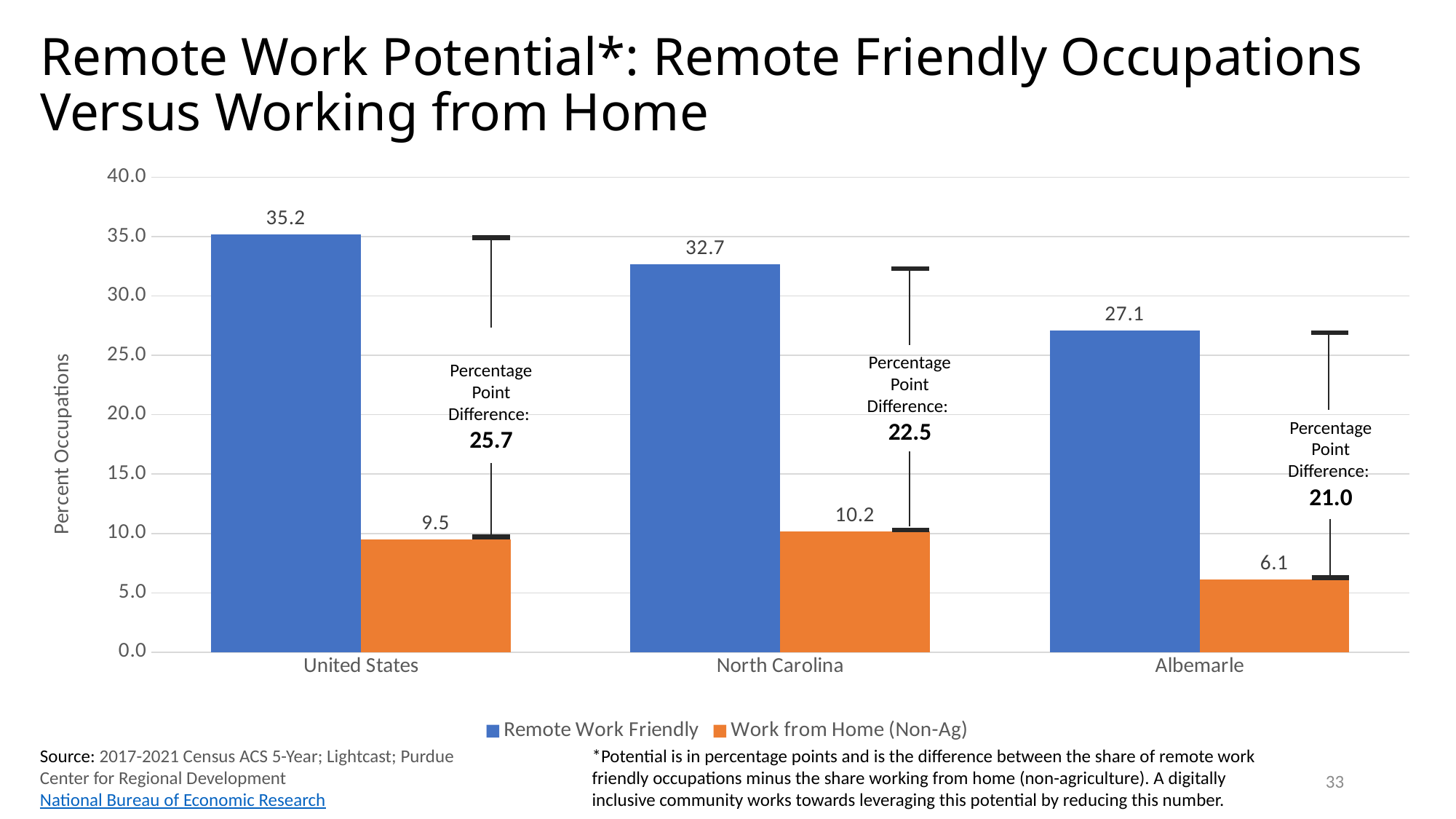
What is the Work from Home (Non-Ag) value for North Carolina? 10.2 What kind of chart is shown on the slide? bar chart Is the Remote Work Friendly value for Albemarle greater or less than 30.0? less Which category has the highest Remote Work Friendly value? United States What is the percentage point difference shown for North Carolina? 22.5 What is the Remote Work Friendly value for the United States? 35.2 Which category has the lowest Work from Home (Non-Ag) value? Albemarle What is the difference between the Remote Work Friendly value for the United States and for Albemarle? 8.1 How many series does the legend list? 2 How many categories are shown on the x axis? 3 Which is larger, the Work from Home (Non-Ag) value for the United States or for North Carolina? North Carolina What is the Work from Home (Non-Ag) value for Albemarle? 6.1